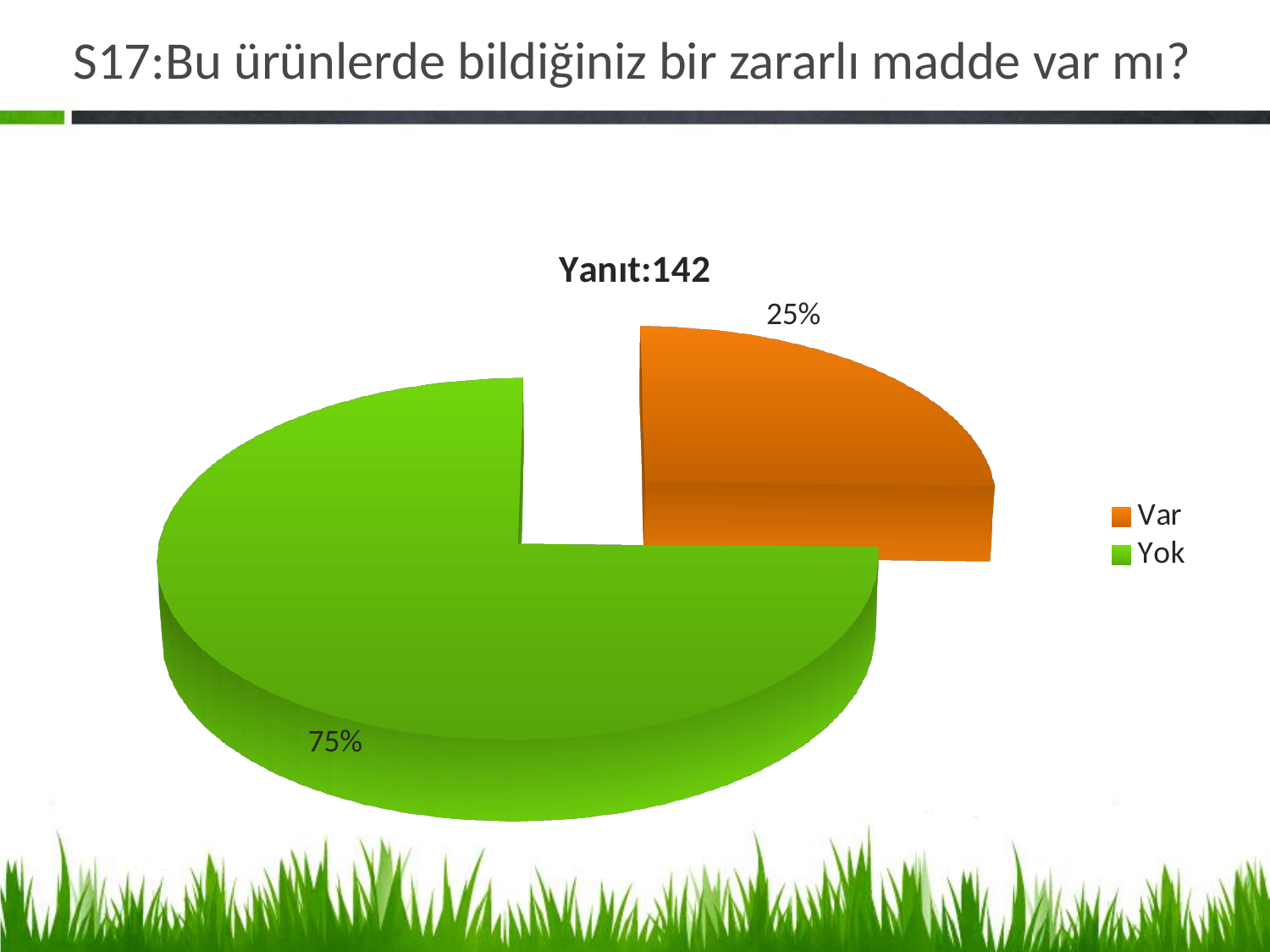
How many entries does the legend list? 2 Which slice is the largest? Yok How many slices does the pie chart have? 2 Which is larger, the Var slice or the Yok slice? Yok What percentage is shown for the Yok slice? 75% Which slice is the smallest? Var What is the chart's title? Yanıt:142 What is the difference in percentage points between the Yok and Var slices? 50 What kind of chart is shown on the slide? pie chart What colour is the Var slice? orange What percentage is shown for the Var slice? 25% What share of the pie does the Yok slice represent? 75%